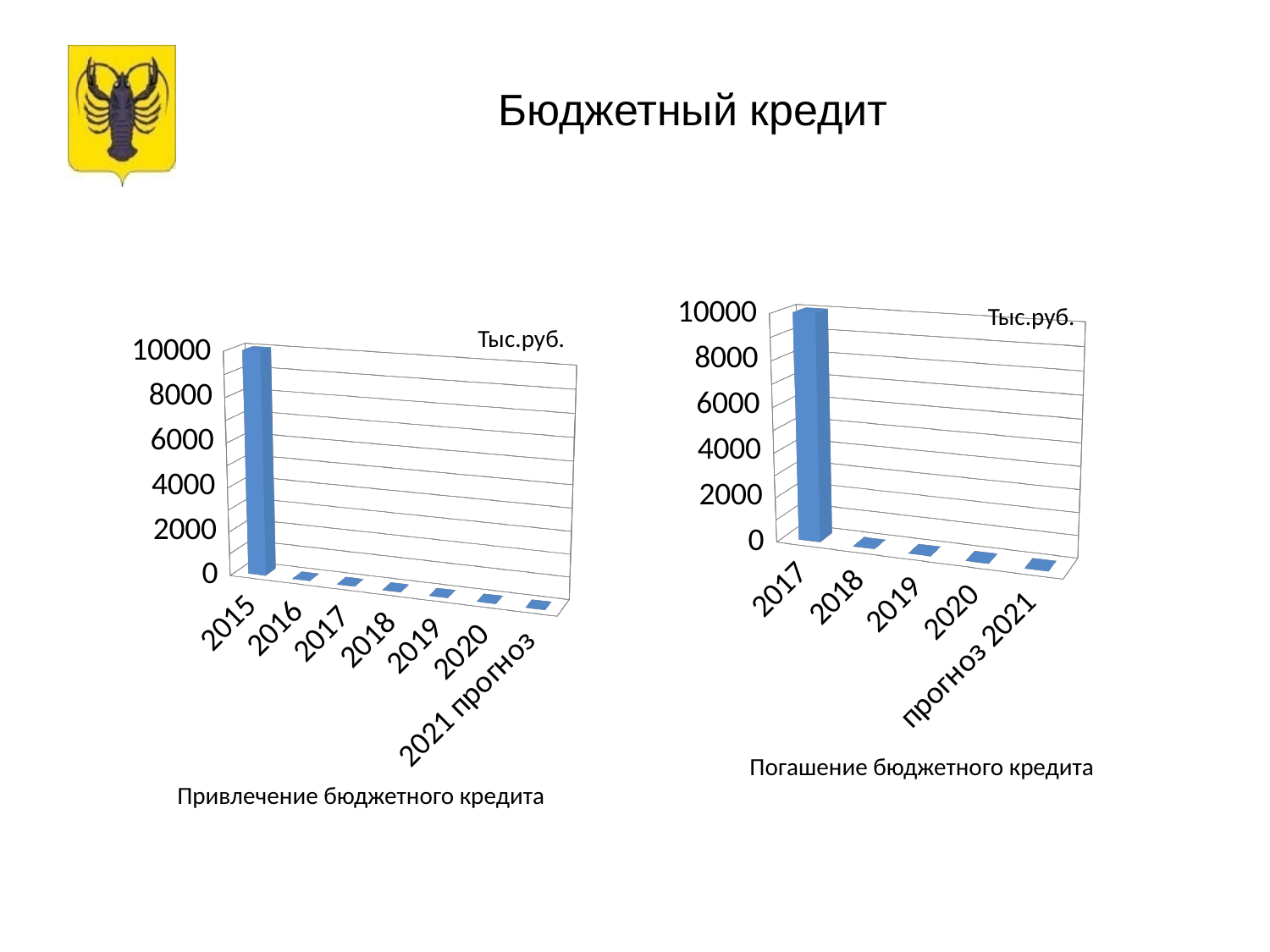
What type of chart is used for "Привлечение бюджетного кредита"? bar chart In the "Привлечение бюджетного кредита" chart, which year has the highest value? 2015 In the "Привлечение бюджетного кредита" chart, is the value for 2018 greater or less than 2000? less In the "Привлечение бюджетного кредита" chart, is the value for 2015 greater or less than 8000? greater How many categories are shown on the x axis of the "Погашение бюджетного кредита" chart? 5 What unit label is shown in the upper right of both charts? Тыс.руб. What is the title of the slide? Бюджетный кредит In the "Погашение бюджетного кредита" chart, which year has the highest value? 2017 In the "Погашение бюджетного кредита" chart, is the value for 2017 greater or less than 8000? greater In the "Привлечение бюджетного кредита" chart, which is larger, the value for 2015 or the value for 2021 прогноз? 2015 In the "Погашение бюджетного кредита" chart, which is larger, the value for 2017 or the value for 2019? 2017 How many categories are shown on the x axis of the "Привлечение бюджетного кредита" chart? 7